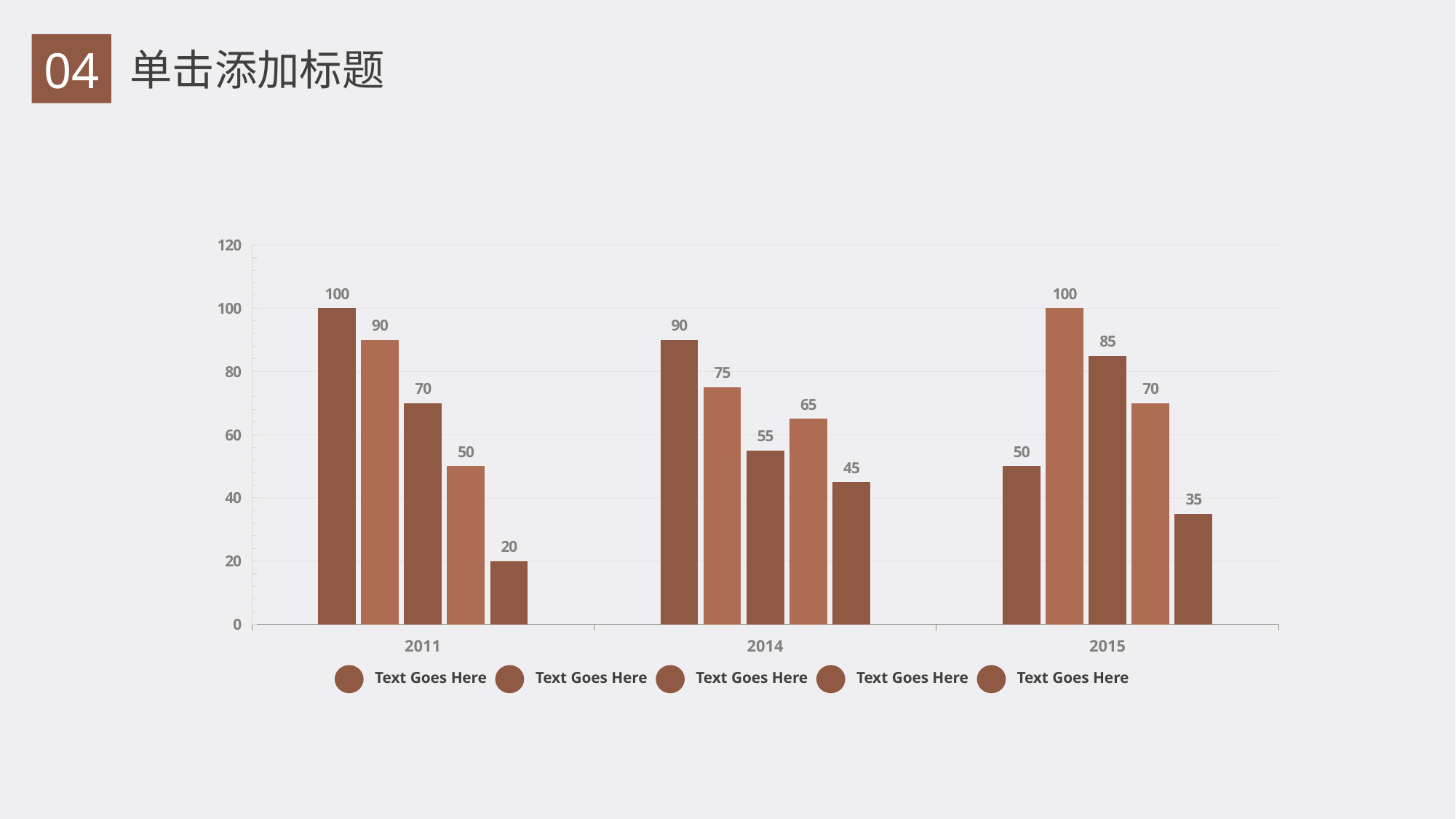
Which bar in the 2015 group has the highest value? the second bar (100) What is the value of the last (rightmost) bar in the 2014 group? 45 Do the values of the first bar in each group rise or fall from 2011 to 2015? fall How many series does the legend list? 5 Which is larger: the fourth bar in the 2014 group or the fourth bar in the 2015 group? the fourth bar in 2015 (70) What type of chart is shown on the slide? bar chart What is the value of the third bar in the 2015 group? 85 What is the value of the first (leftmost) bar in the 2011 group? 100 Which bar in the 2011 group has the lowest value? the last bar (20) How many categories are shown on the x axis? 3 What is the difference between the first bar in 2011 and the first bar in 2015? 50 What label is shown for every entry in the legend? Text Goes Here